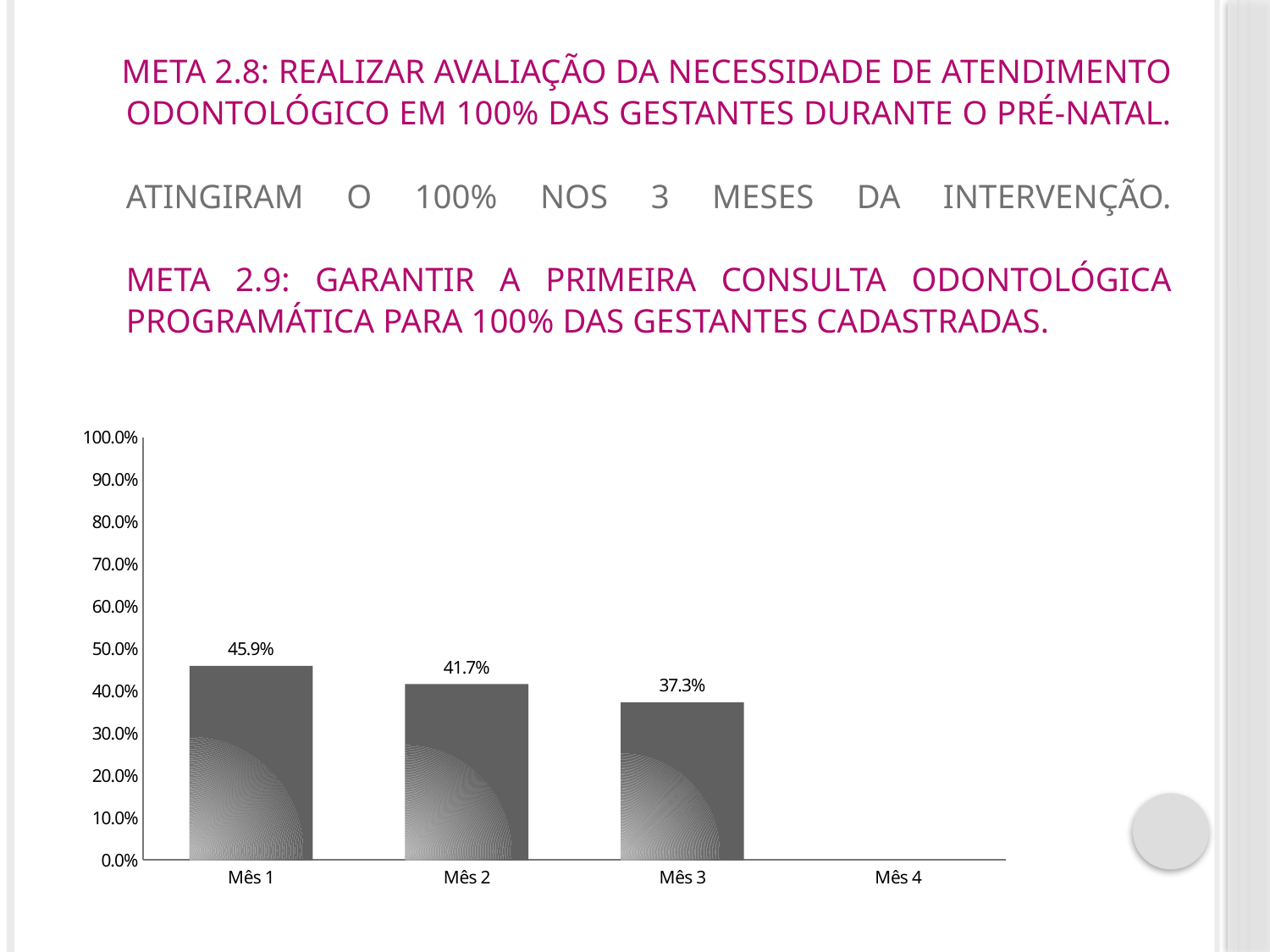
What kind of chart is shown on the slide? bar chart What is the value for Mês 2? 41.7% Do the values rise or fall from Mês 1 to Mês 3? fall What is the difference between the values for Mês 1 and Mês 2? 4.2% Among the months with a visible bar, which has the lowest value? Mês 3 Which month has the highest value? Mês 1 How many categories are shown on the x axis? 4 What is the value for Mês 1? 45.9% Which is larger, the value for Mês 2 or the value for Mês 3? Mês 2 What is the value for Mês 3? 37.3% Is the value for Mês 1 greater or less than 50.0%? less What is the difference between the values for Mês 1 and Mês 3? 8.6%